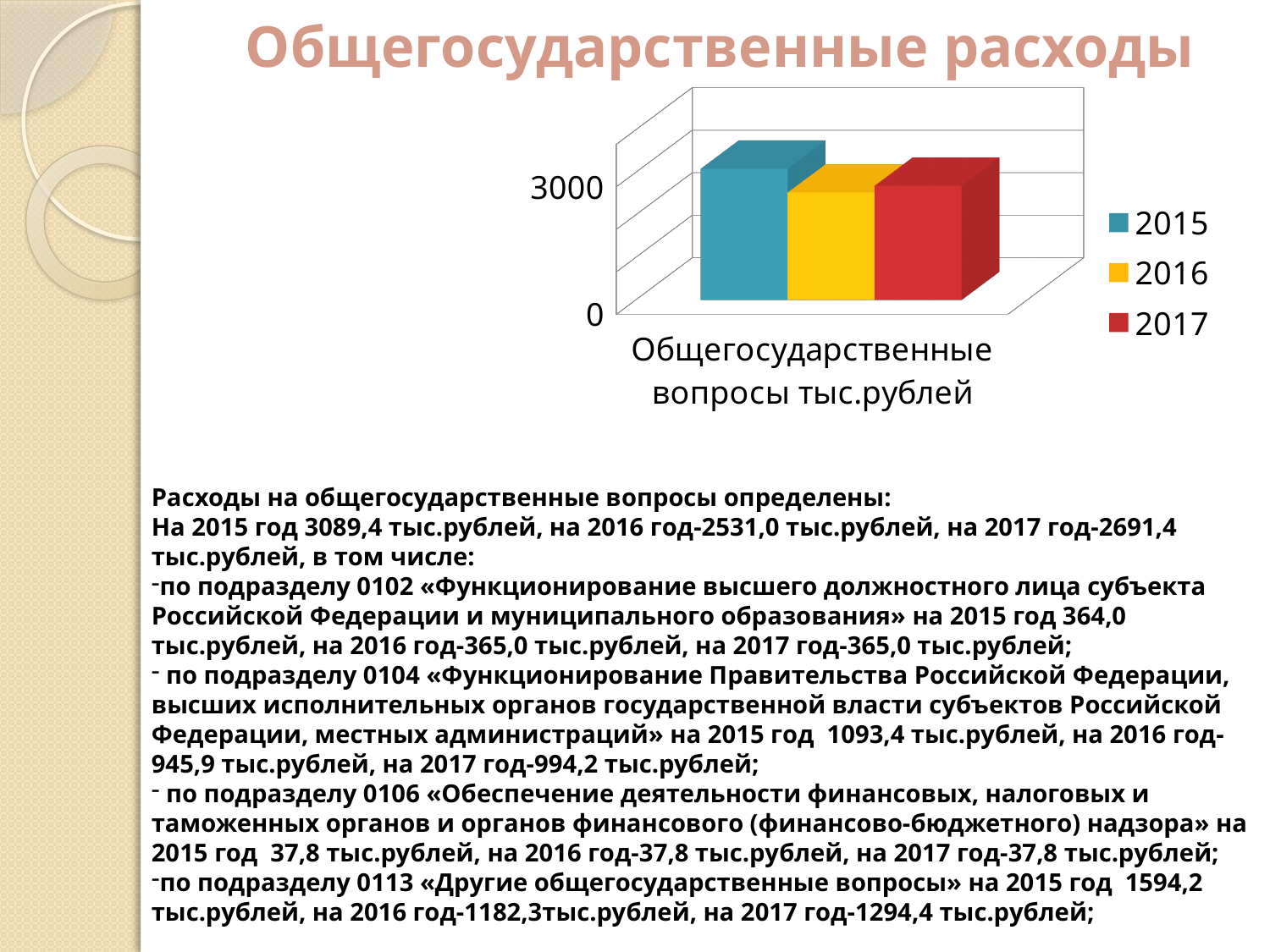
According to the slide, what is the value of general state expenditures (Общегосударственные вопросы) for 2016? 2531,0 тыс.рублей How many series does the chart legend list? 3 What is the category label shown on the x axis of the chart? Общегосударственные вопросы тыс.рублей Which is larger in the chart, the bar for 2016 or the bar for 2017? 2017 Which year has the lowest bar in the chart? 2016 What kind of chart is shown on the slide? bar chart How many categories are shown on the x axis of the chart? 1 What colour is the bar for 2017 in the chart? red Which year has the highest bar in the chart? 2015 Is the value for 2016 greater or less than 3000? less According to the slide, what is the value of general state expenditures (Общегосударственные вопросы) for 2015? 3089,4 тыс.рублей Is the value for 2017 greater or less than 3000? less